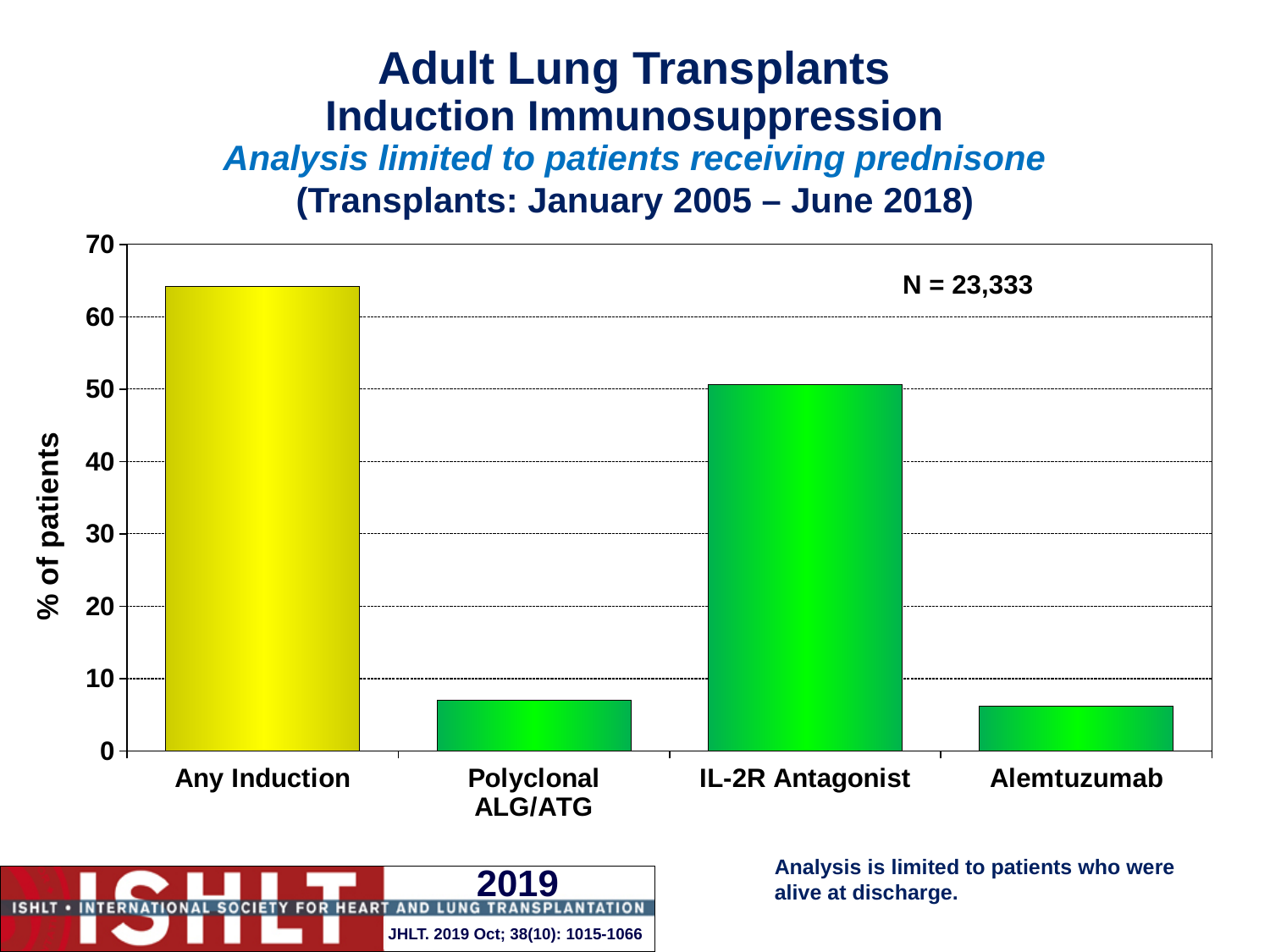
Which is larger, the value for IL-2R Antagonist or the value for Polyclonal ALG/ATG? IL-2R Antagonist Which induction category has the highest percentage of patients? Any Induction Is the value for Polyclonal ALG/ATG greater or less than 10? less What is the label on the y axis of the chart? % of patients Is the value for IL-2R Antagonist greater or less than 60? less Is the value for IL-2R Antagonist greater or less than 40? greater What kind of chart is shown on the slide? bar chart Which is larger, the value for Any Induction or the value for IL-2R Antagonist? Any Induction What sample size (N) is printed on the chart? N = 23,333 How many induction categories are plotted on the x axis? 4